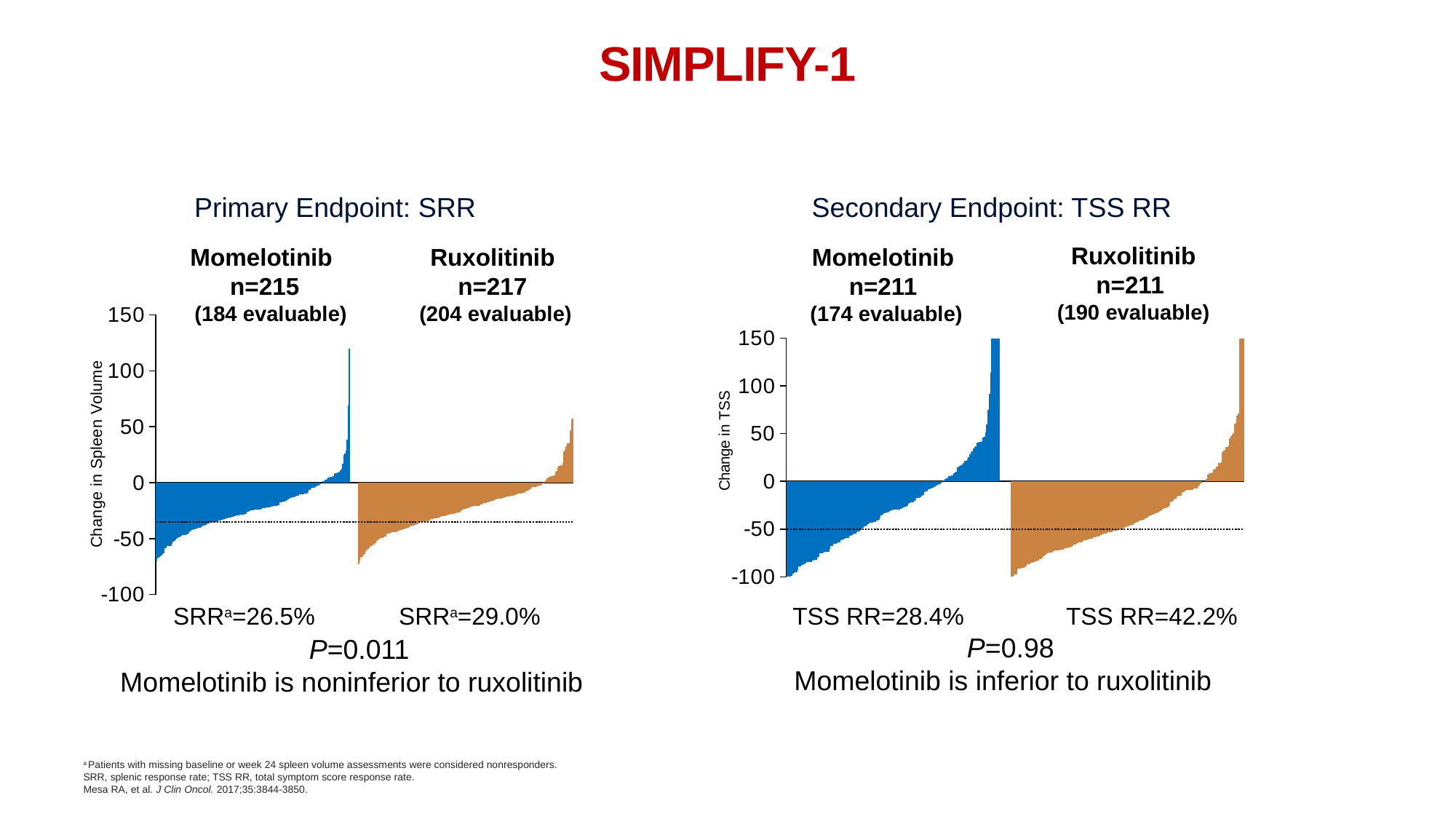
What kind of chart is used for the Primary Endpoint: SRR panel? Bar chart In the Secondary Endpoint: TSS RR chart, what is the TSS RR for ruxolitinib? 42.2% In the Secondary Endpoint: TSS RR chart, what is the n for the ruxolitinib arm? 211 In the Secondary Endpoint: TSS RR chart, which treatment has the higher TSS RR? Ruxolitinib In the Primary Endpoint: SRR chart, what is the SRR for momelotinib? 26.5% In the Primary Endpoint: SRR chart, what is the SRR for ruxolitinib? 29.0% In the Secondary Endpoint: TSS RR chart, what is the TSS RR for momelotinib? 28.4% What is the y-axis label of the Secondary Endpoint: TSS RR chart? Change in TSS In the Secondary Endpoint: TSS RR chart, what is the difference in TSS RR between ruxolitinib and momelotinib? 13.8 percentage points In the Primary Endpoint: SRR chart, how many momelotinib patients were evaluable? 184 In the Primary Endpoint: SRR chart, is the largest positive change in spleen volume for momelotinib greater or less than 100? greater In the Primary Endpoint: SRR chart, what is the difference in SRR between ruxolitinib and momelotinib? 2.5 percentage points